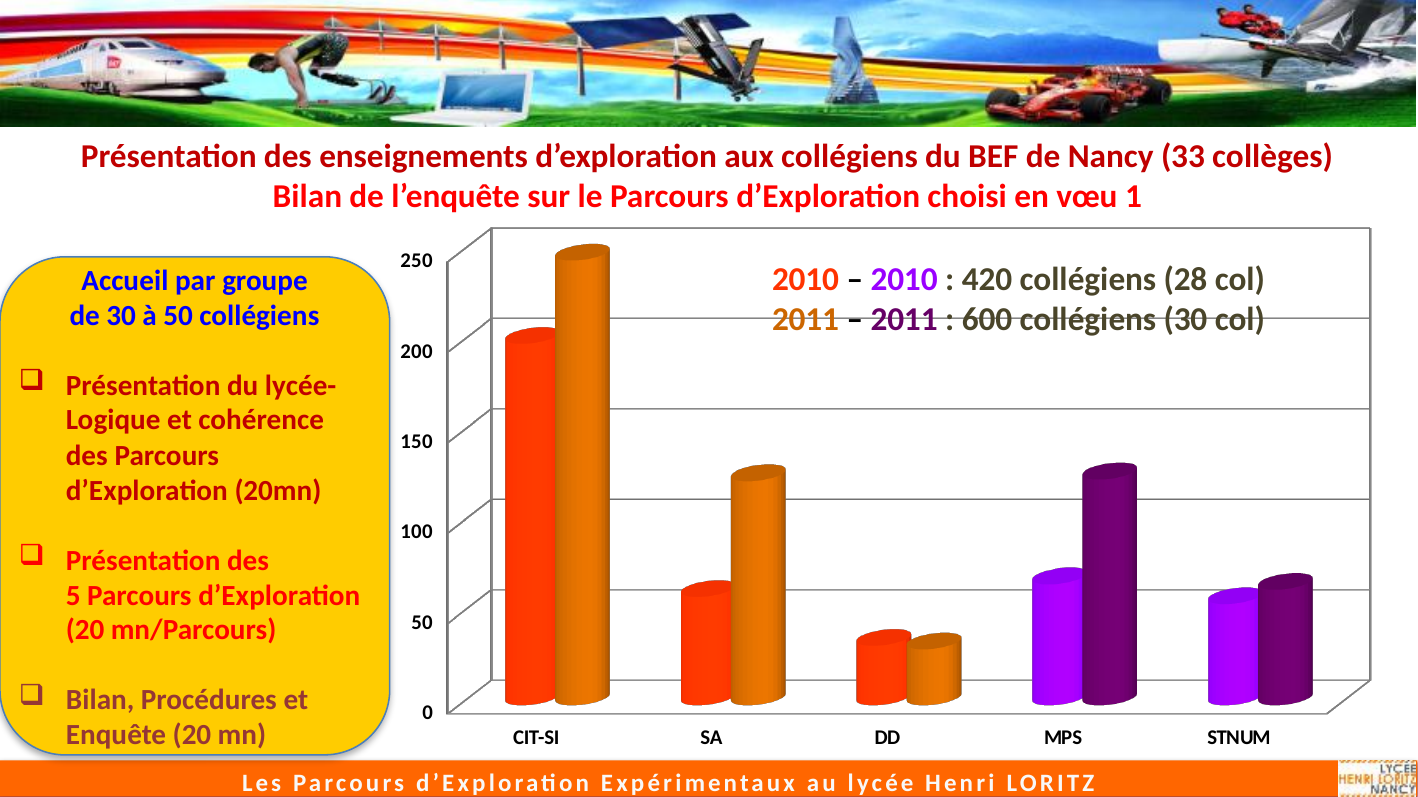
Is the 2011 value for MPS greater or less than 100? greater Is the 2011 value for CIT-SI greater or less than 200? greater According to the chart's legend, how many collégiens were surveyed in 2011? 600 collégiens (30 col) Which category has the lowest bars in the chart? DD Which is larger, the 2011 value for CIT-SI or the 2011 value for MPS? CIT-SI How many series does the chart's legend list? 2 Is the 2011 value for SA greater or less than 100? greater What kind of chart is shown on the slide? bar chart How many categories are shown on the x axis of the chart? 5 For SA, which series has the larger value, 2010 or 2011? 2011 Which category has the highest bar in the chart? CIT-SI